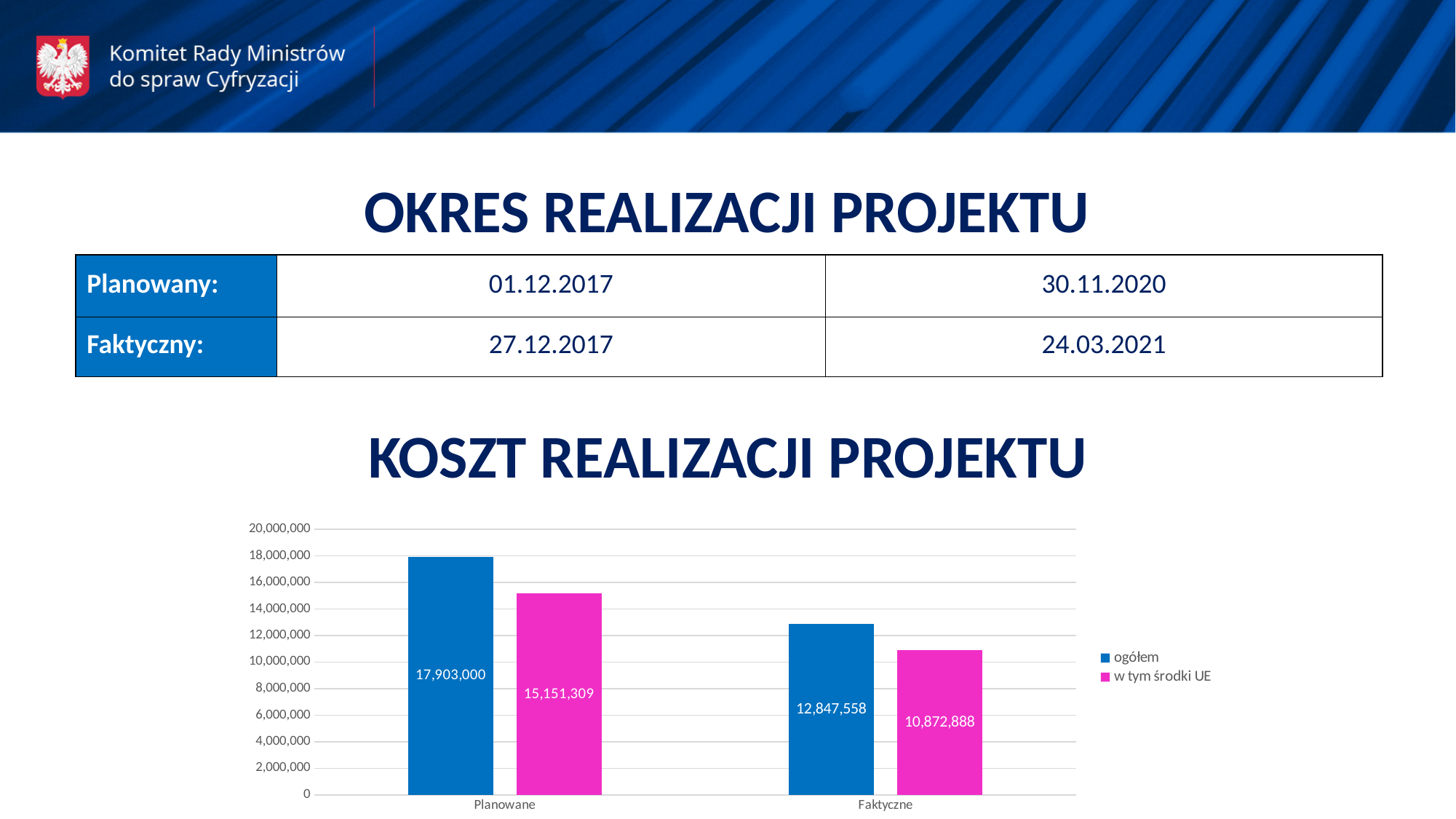
Which is larger: 'w tym środki UE' for Planowane or 'ogółem' for Faktyczne? 'w tym środki UE' for Planowane What is the value of 'w tym środki UE' for Faktyczne? 10,872,888 What is the difference between the 'ogółem' values for Planowane and Faktyczne? 5,055,442 How many categories are shown on the x axis of the chart? 2 What type of chart is shown under 'KOSZT REALIZACJI PROJEKTU'? Bar chart What is the value of 'w tym środki UE' for Planowane? 15,151,309 What is the value of 'ogółem' for Faktyczne? 12,847,558 Which category has the highest 'ogółem' value? Planowane Which category has the lowest 'w tym środki UE' value? Faktyczne What is the difference between 'ogółem' and 'w tym środki UE' for Planowane? 2,751,691 How many series does the chart legend list? 2 What is the value of 'ogółem' for Planowane? 17,903,000